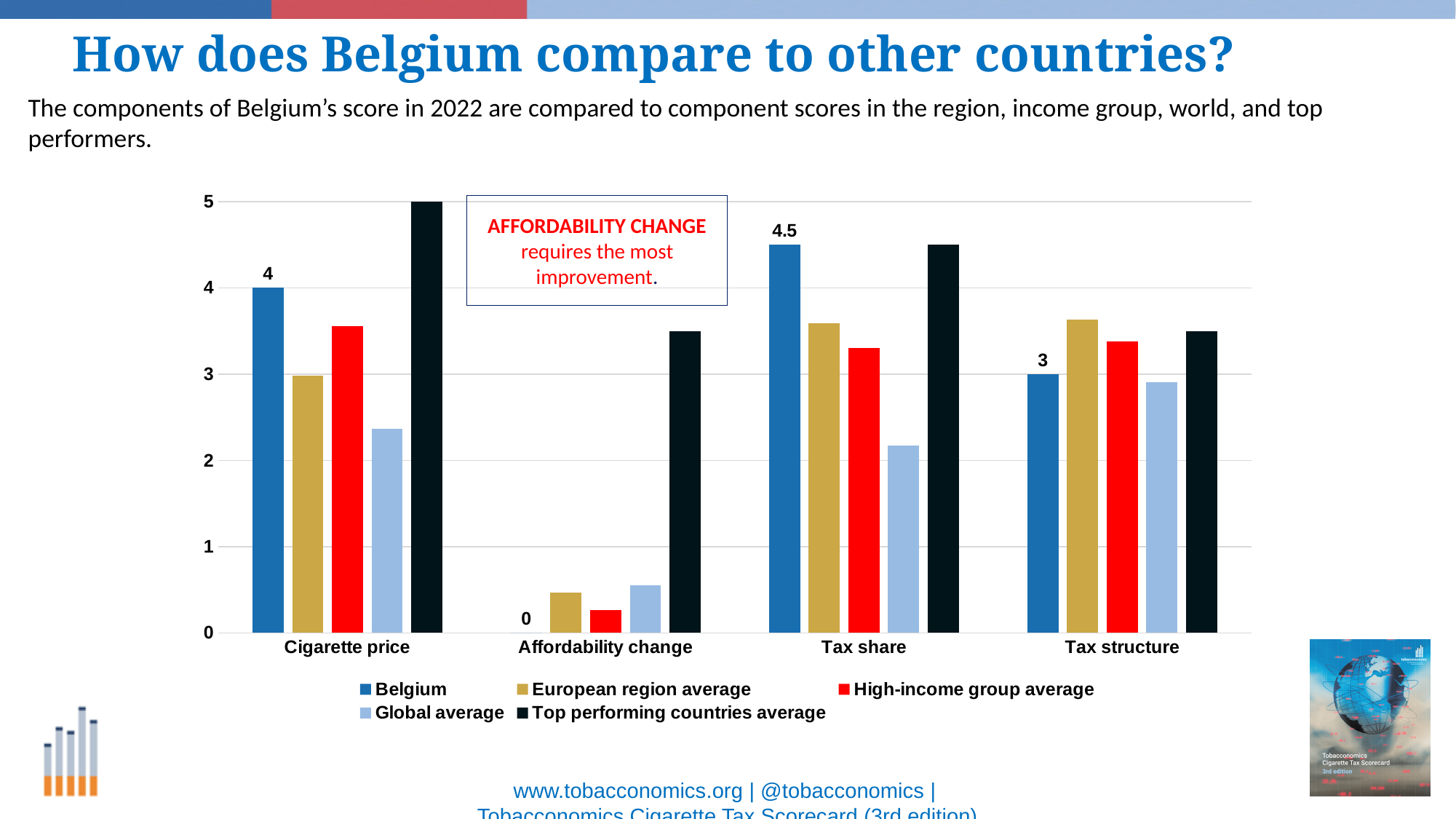
Is the European region average for Tax structure greater or less than 3? greater What is the difference between Belgium's Tax share score and its Cigarette price score? 0.5 In which component does Belgium have its highest score? Tax share What is Belgium's score for Cigarette price? 4 Is the Global average for Cigarette price greater or less than 3? less What is Belgium's score for Tax share? 4.5 What is Belgium's score for Affordability change? 0 Which is larger for Belgium: the Cigarette price score or the Tax structure score? Cigarette price How many components (categories) are shown on the x axis? 4 What is Belgium's score for Tax structure? 3 In which component does Belgium have its lowest score? Affordability change How many series does the legend list? 5